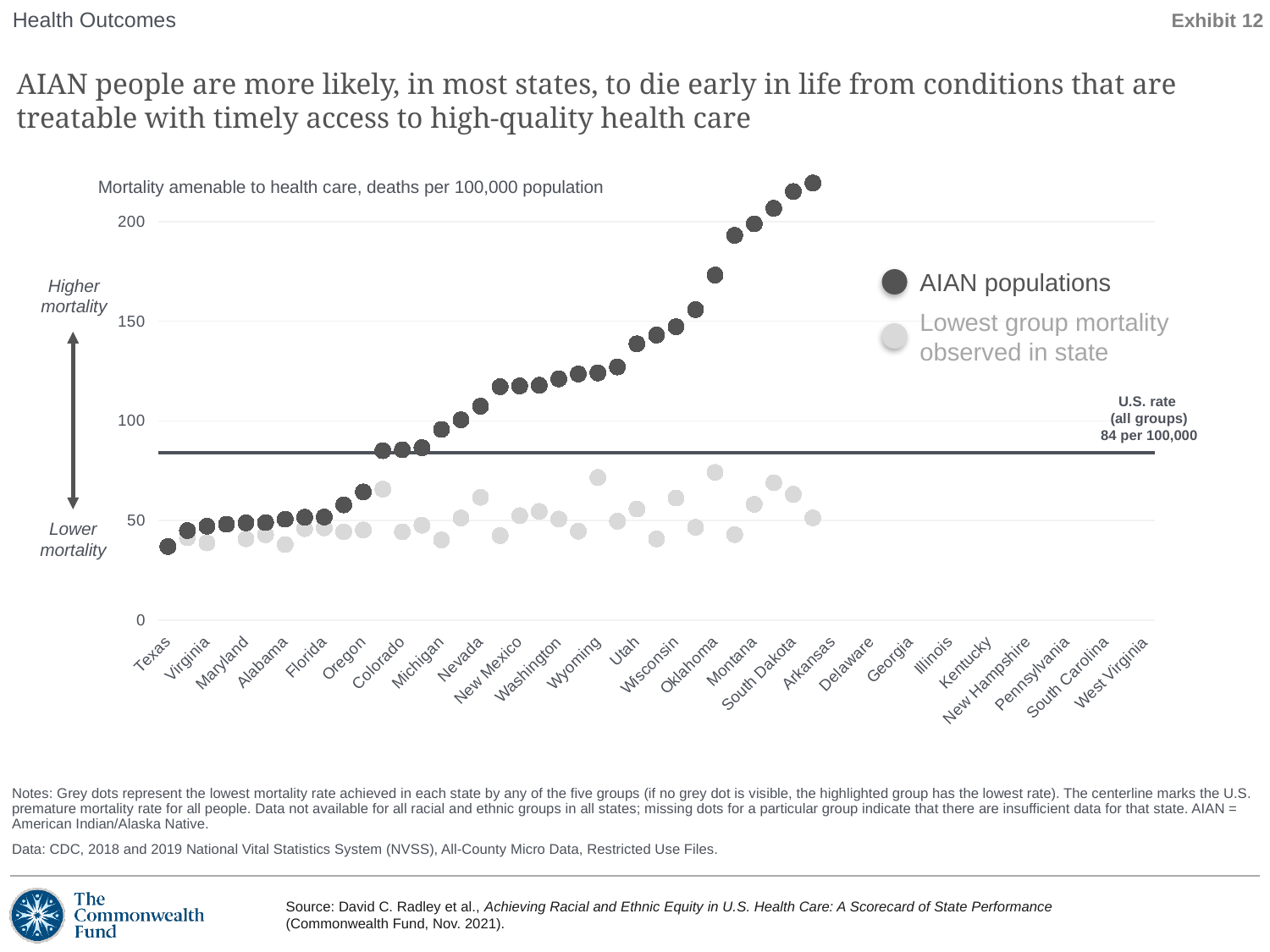
Is the highest AIAN population value on the chart greater or less than 200? greater Is the AIAN population value for Texas greater or less than 50? less How many series does the legend list? 2 How many state labels are shown on the x axis? 26 Is the AIAN population value for Texas greater or less than 100? less Which state label appears last on the x axis? West Virginia Which legend entry is shown with the dark grey dots? AIAN populations What is the U.S. rate (all groups) marked by the horizontal line? 84 per 100,000 Do the AIAN population values rise or fall from left to right along the x axis? Rise Which state is the first category on the x axis? Texas What kind of chart is shown on the slide? Dot (scatter) chart What is the title of the chart? Mortality amenable to health care, deaths per 100,000 population